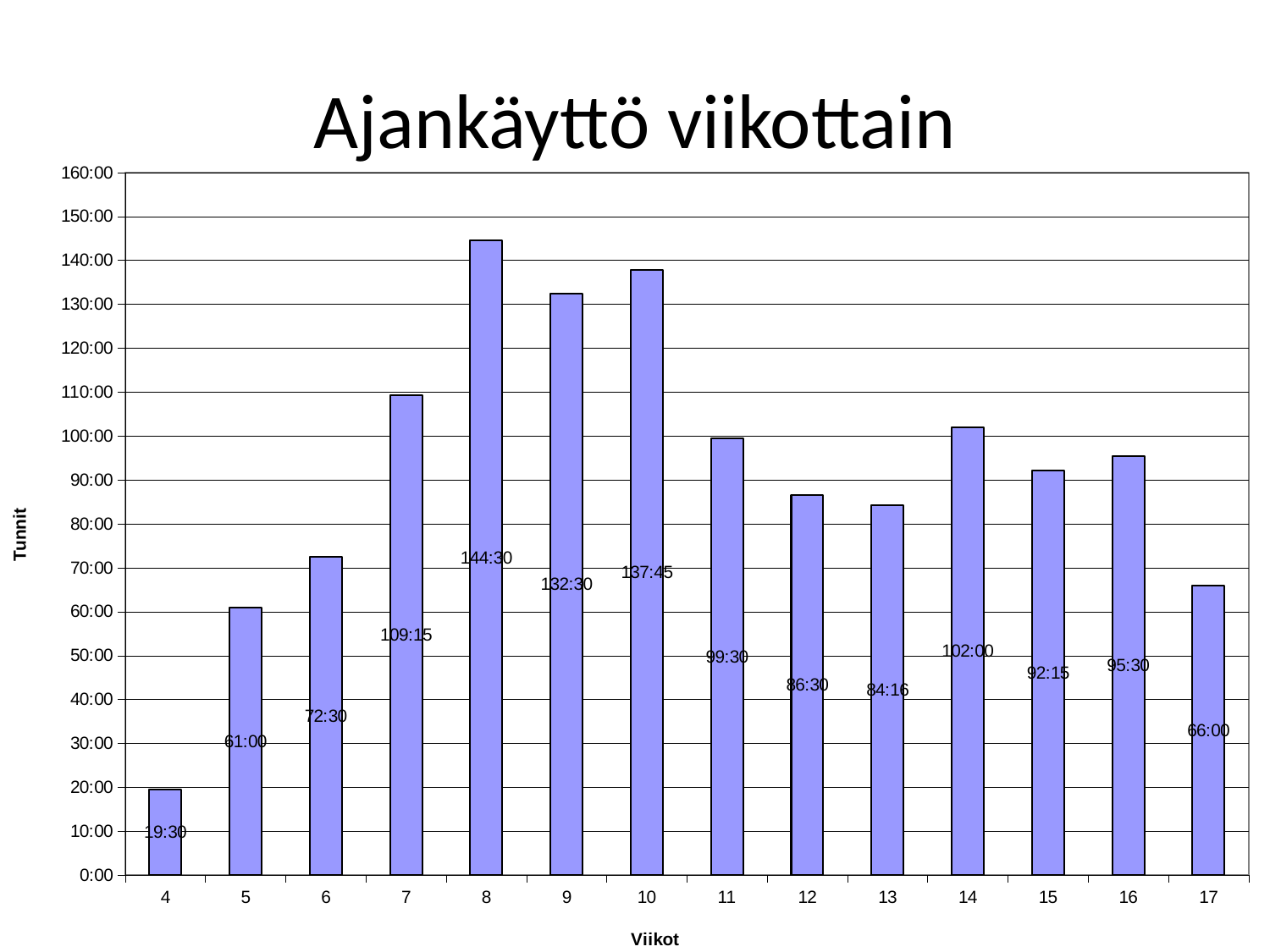
What is the difference between the values for week 8 and week 9? 12:00 Which is larger, the value for week 10 or the value for week 9? week 10 What is the title of the chart? Ajankäyttö viikottain Which week has the lowest value? 4 What is the value for week 13? 84:16 What is the value for week 17? 66:00 Which week has the highest value? 8 What is the difference between the values for week 5 and week 6? 11:30 What kind of chart is shown on the slide? bar chart Is the value for week 7 greater or less than 100:00? greater How many weeks are shown on the x axis? 14 What is the value for week 8? 144:30